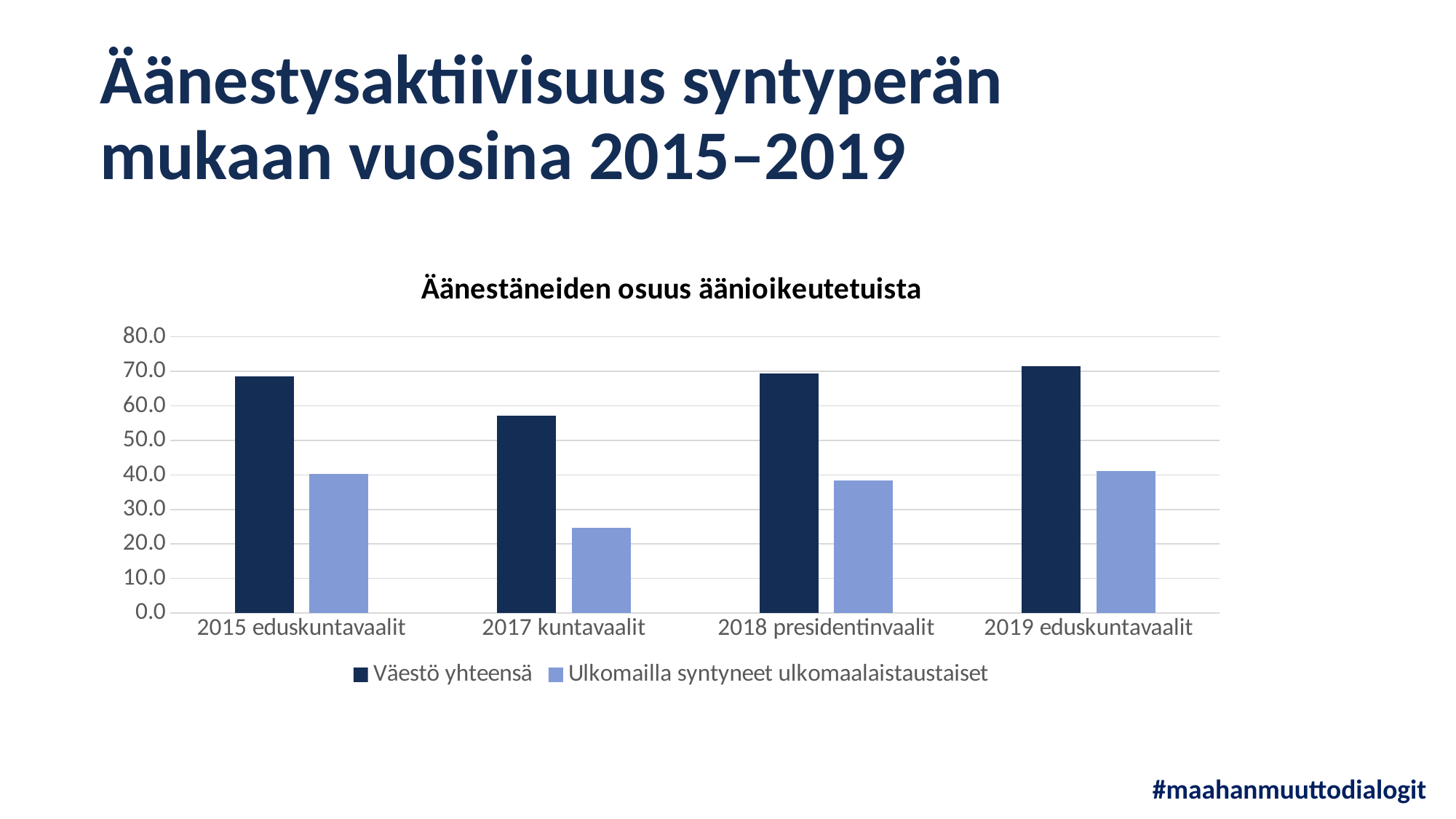
What kind of chart is shown on the slide? bar chart Is the value for Väestö yhteensä in 2019 eduskuntavaalit greater or less than 70.0? greater How many election categories are shown on the x axis? 4 Is the value for Ulkomailla syntyneet ulkomaalaistaustaiset in 2017 kuntavaalit greater or less than 30.0? less In which election is the value for Väestö yhteensä lowest? 2017 kuntavaalit Which is larger: the Väestö yhteensä value in 2015 eduskuntavaalit or in 2017 kuntavaalit? 2015 eduskuntavaalit Which series is shown in dark navy bars? Väestö yhteensä How many series does the legend list? 2 In which election is the value for Väestö yhteensä highest? 2019 eduskuntavaalit Is the value for Väestö yhteensä in 2017 kuntavaalit greater or less than 60.0? less What is the title of the chart? Äänestäneiden osuus äänioikeutetuista In which election is the value for Ulkomailla syntyneet ulkomaalaistaustaiset lowest? 2017 kuntavaalit